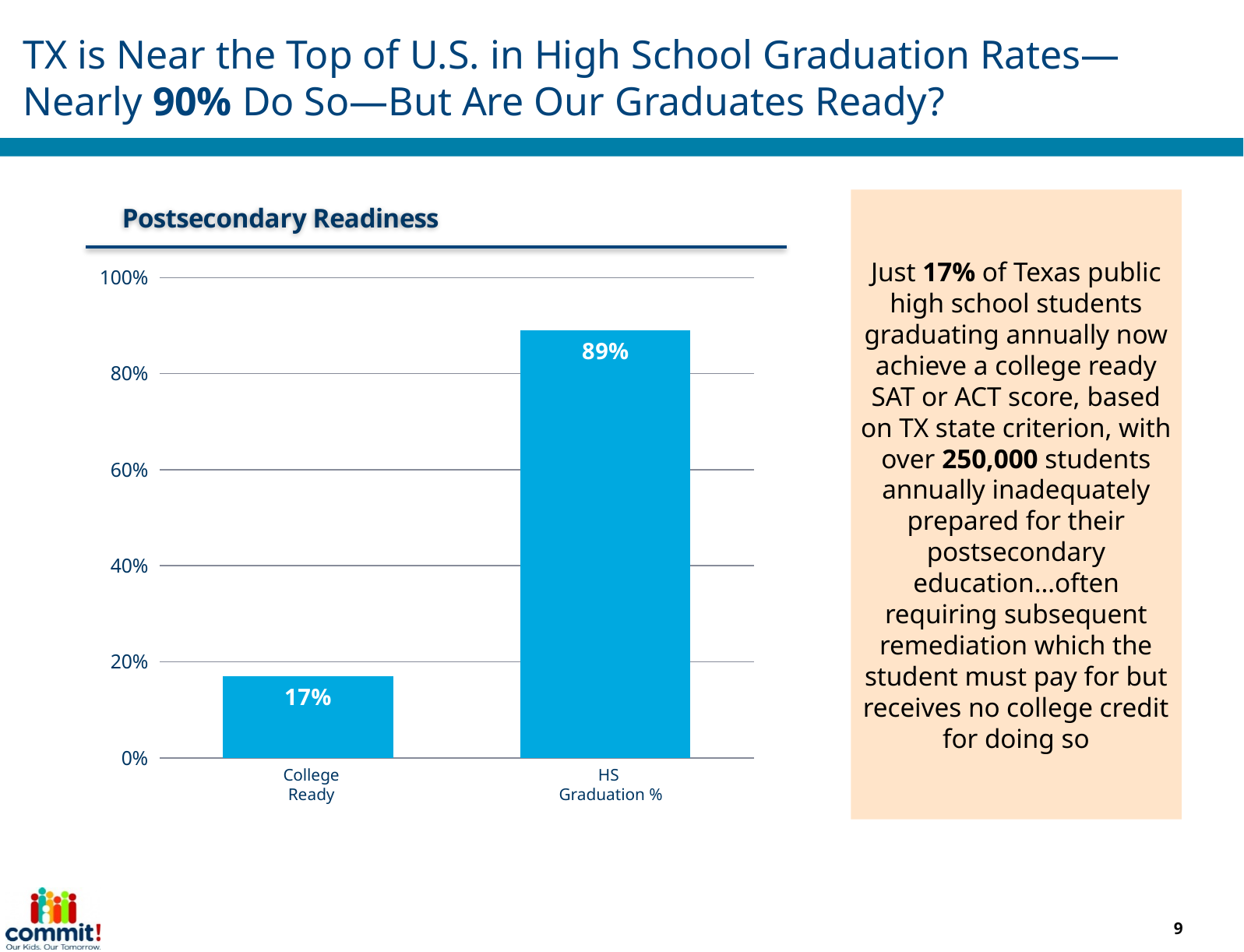
Which category has the highest value? HS Graduation % Which is larger, the value for College Ready or the value for HS Graduation %? HS Graduation % How many categories are shown on the chart? 2 Which category has the lowest value? College Ready What is the title of the chart? Postsecondary Readiness Is the value for HS Graduation % greater or less than 80%? greater What kind of chart is shown on the slide? bar chart What is the value for HS Graduation %? 89% What is the highest value shown on the chart's vertical axis? 100% What is the value for College Ready? 17% Is the value for College Ready greater or less than 20%? less What is the difference between the HS Graduation % value and the College Ready value? 72%